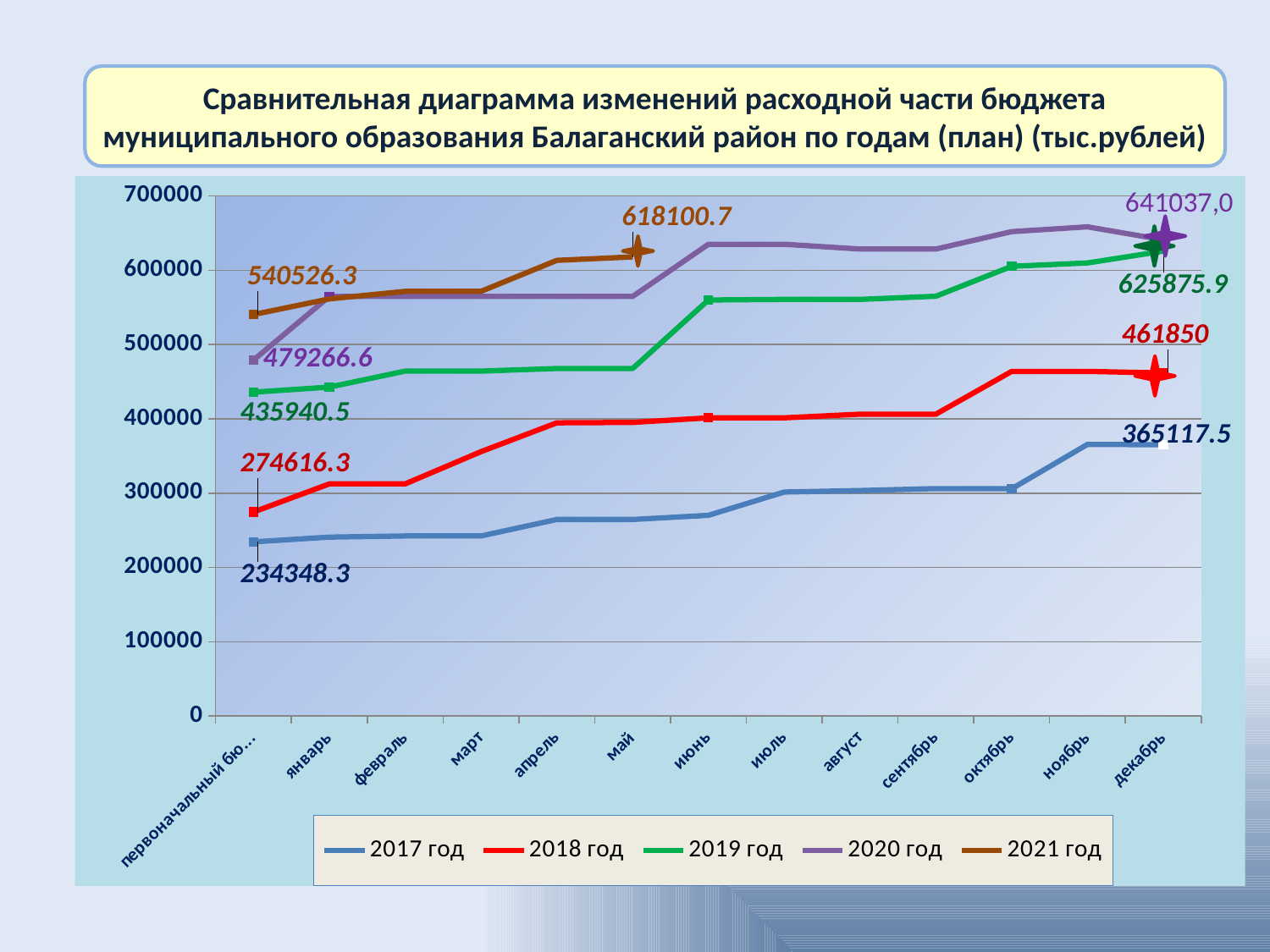
How many series does the legend list? 5 What kind of chart is shown on the slide? line chart What is the difference between the декабрь value and the first (первоначальный) value for 2017 год? 130769.2 What is the value for 2020 год in декабрь? 641037,0 What is the value for 2021 год in май? 618100.7 What is the value for 2018 год in декабрь? 461850 Does the 2017 год series rise or fall from the first point to декабрь? rise What is the value for 2019 год in декабрь? 625875.9 How many categories are shown on the x axis? 13 Is the value for 2019 год in июнь greater or less than 500000? greater Which series has the higher value in декабрь, 2019 год or 2020 год? 2020 год What is the value for 2017 год at the first point (первоначальный бюджет)? 234348.3